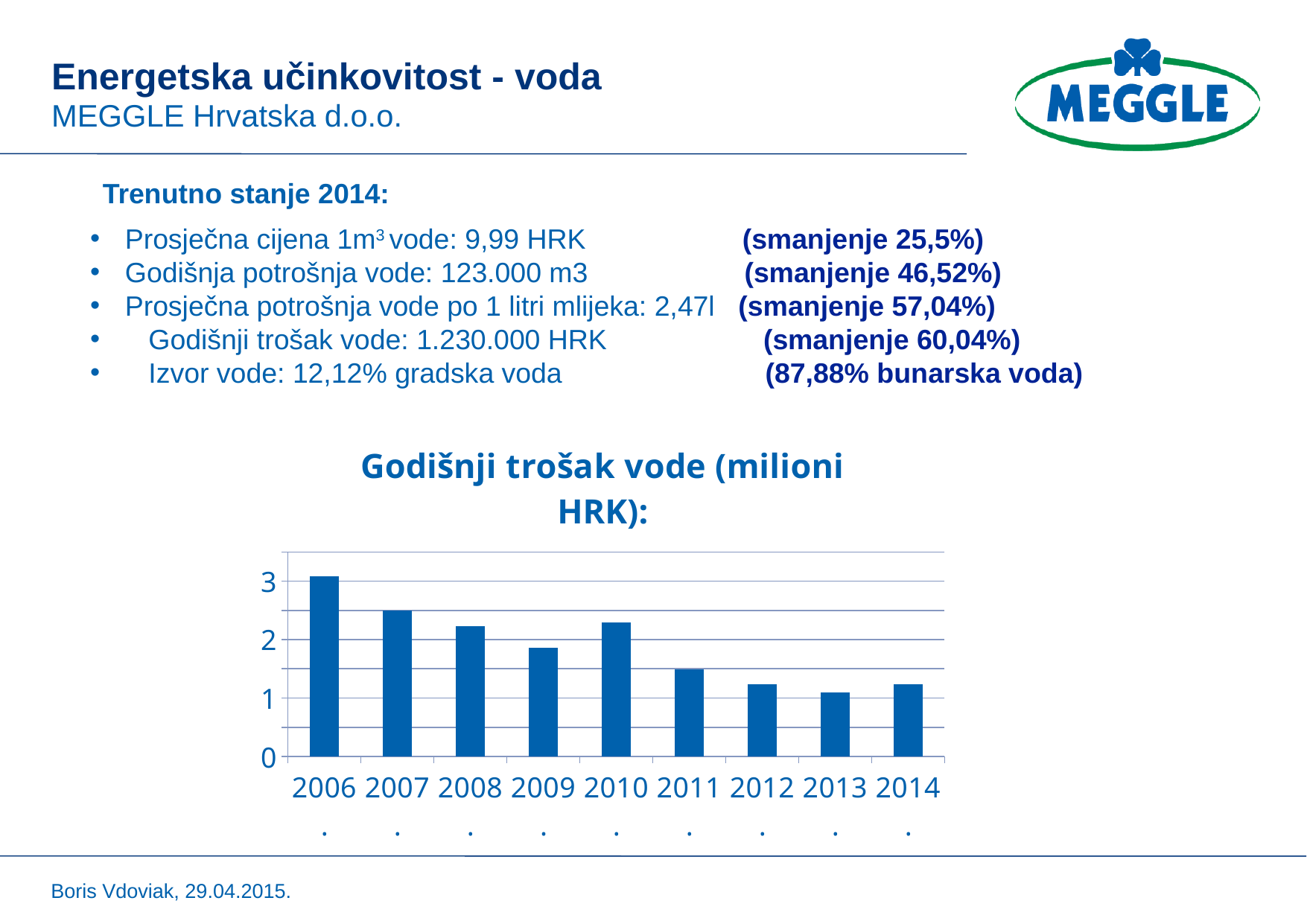
How many years are shown on the x axis of the chart? 9 Is the value for 2009 greater or less than 2? less Is the value for 2011 greater or less than 1? greater Is the value for 2014 greater or less than 2? less Overall, do the annual water cost values rise or fall from 2006 to 2014? fall What kind of chart is shown on the slide? bar chart What is the title of the chart? Godišnji trošak vode (milioni HRK): Which year has the highest annual water cost in the chart? 2006 Which year has a higher annual water cost, 2007 or 2010? 2007 Which year has the lowest annual water cost in the chart? 2013 Which year has a higher annual water cost, 2009 or 2011? 2009